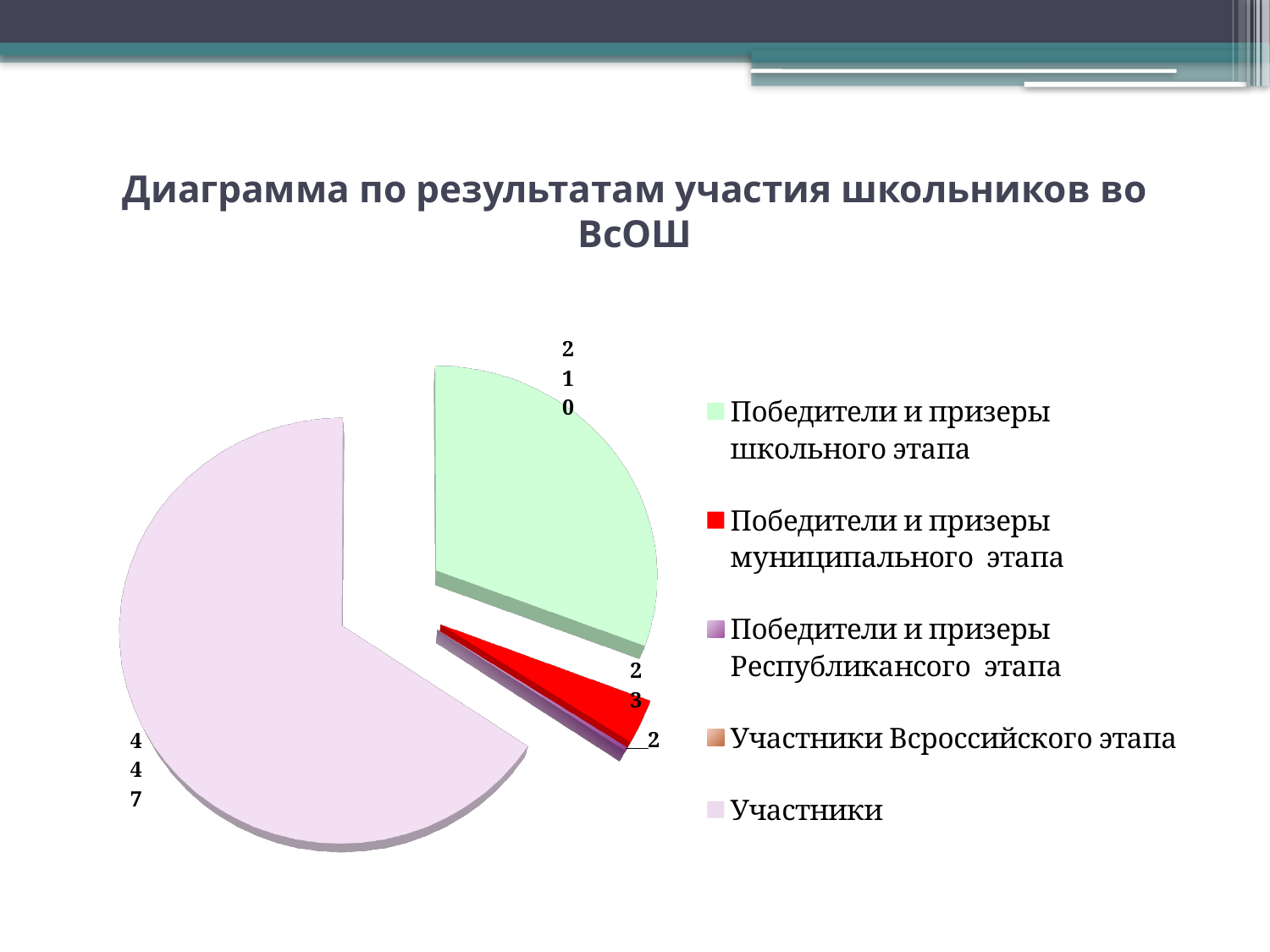
How many entries does the legend list? 5 Which labelled slice has the smallest value? Победители и призеры Республиканского этапа What value is shown for Победители и призеры Республиканского этапа? 2 What value is shown for Победители и призеры муниципального этапа? 23 Which is larger: Победители и призеры школьного этапа or Победители и призеры муниципального этапа? Победители и призеры школьного этапа What is the title of the chart on the slide? Диаграмма по результатам участия школьников во ВсОШ Which category has the largest slice of the pie? Участники What value is shown for Победители и призеры школьного этапа? 210 What is the difference between the муниципального этапа value and the Республиканского этапа value? 21 What kind of chart is shown on the slide? Pie chart What is the difference between the Участники value and the Победители и призеры школьного этапа value? 237 What value is shown for the Участники slice? 447